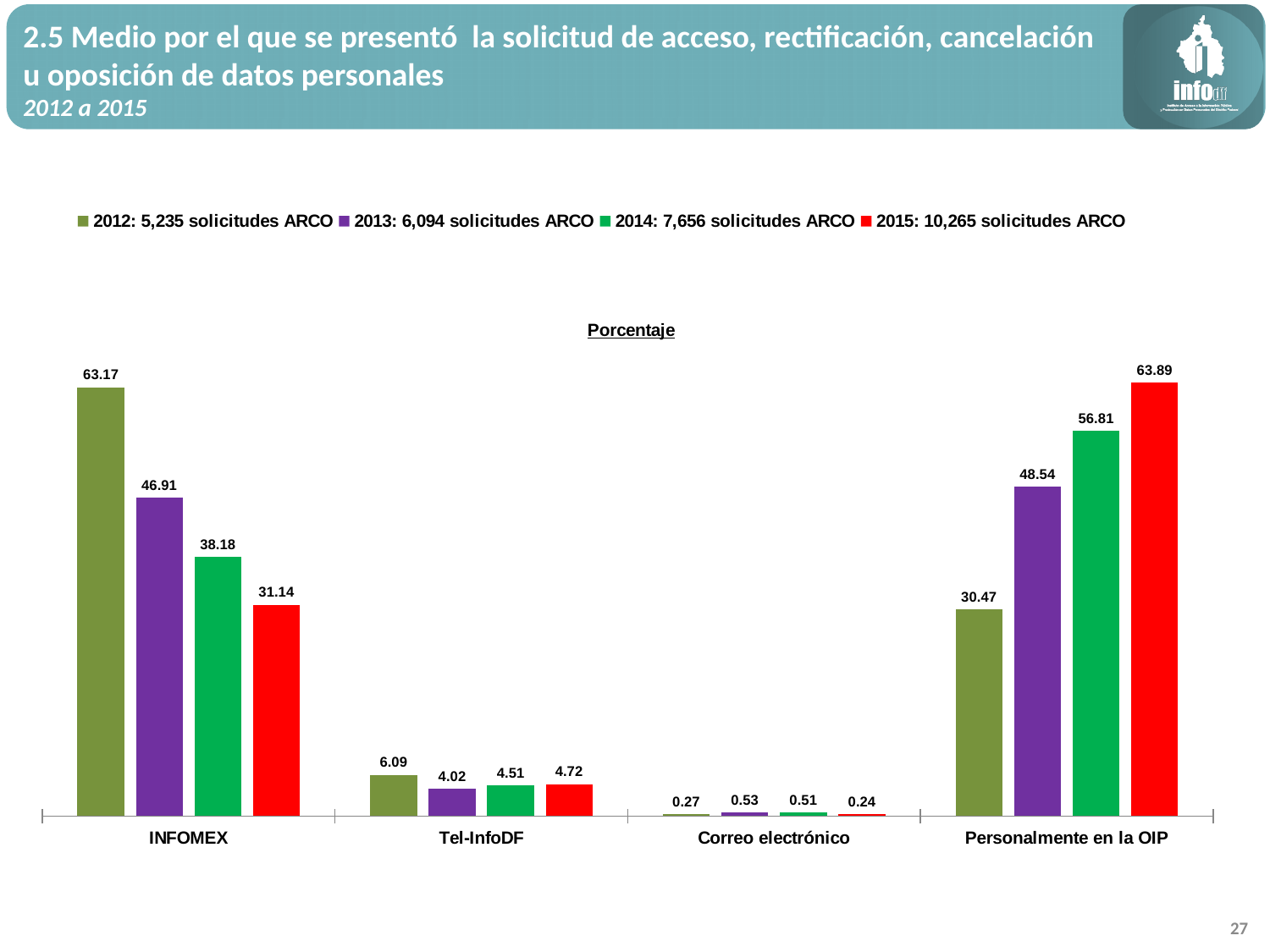
Do the values for INFOMEX rise or fall from 2012 to 2015? fall How many series does the legend list? 4 What is the difference between the 2012 and 2015 values for INFOMEX? 32.03 Which category has the highest value in the 2015 series? Personalmente en la OIP How many categories are shown on the x axis? 4 What is the value for INFOMEX in the 2012 series? 63.17 Which is larger for Personalmente en la OIP: the 2013 value or the 2014 value? 2014 What is the value for Personalmente en la OIP in the 2015 series? 63.89 What is the value for Correo electrónico in the 2014 series? 0.51 Which category has the lowest value in the 2012 series? Correo electrónico What is the value for Tel-InfoDF in the 2013 series? 4.02 What kind of chart is shown on the slide? bar chart